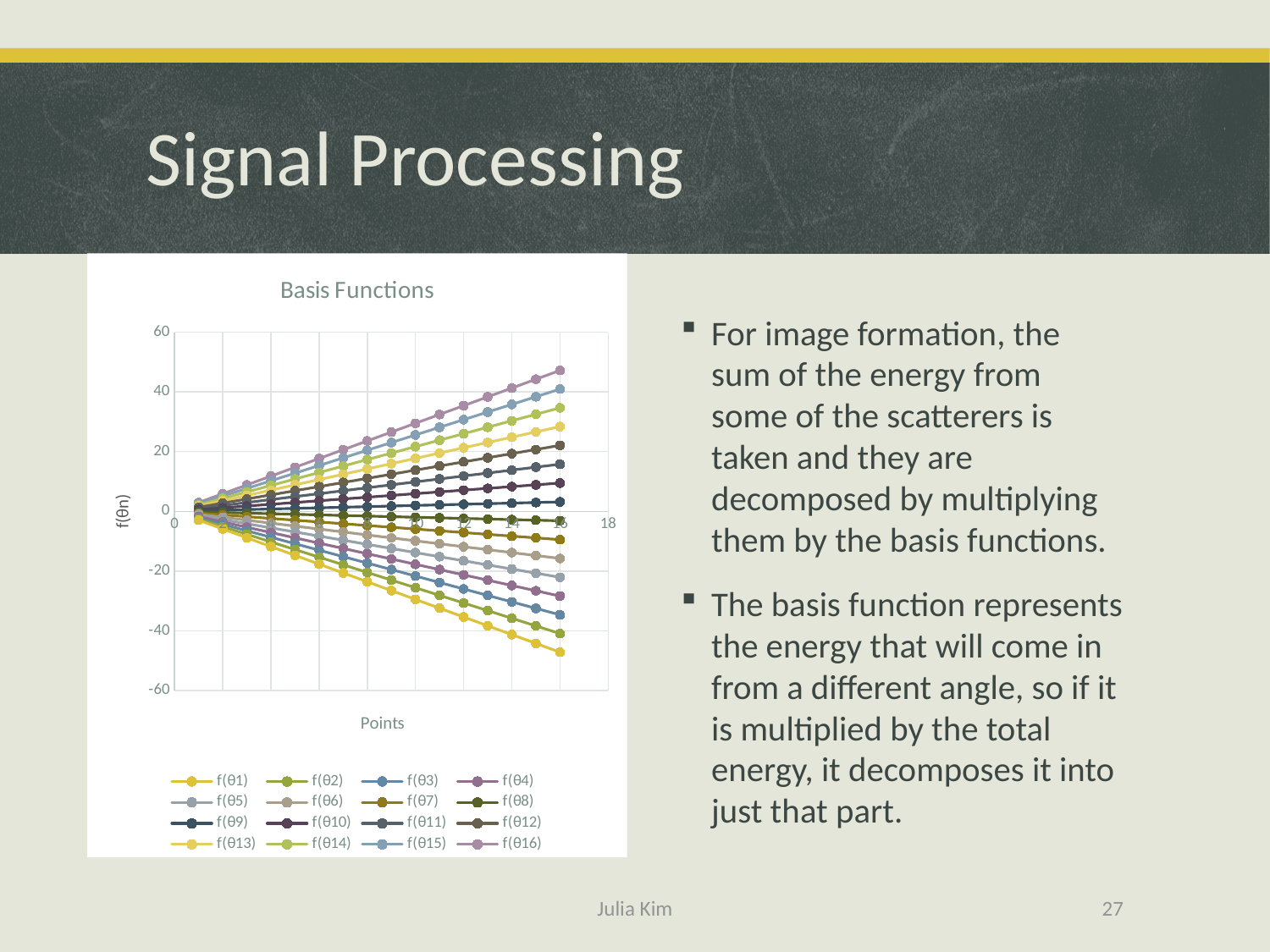
What is the lowest tick value shown on the y axis of the chart? -60 What is the label of the x axis of the chart? Points Is the highest value plotted at x = 16 greater or less than 40? greater Do the values of the topmost line rise or fall as x increases? rise What is the highest tick value shown on the x axis of the chart? 18 Do the values of the bottommost line rise or fall as x increases? fall Is the highest value plotted at x = 8 greater or less than 40? less What kind of chart is shown on the slide? line chart Is the lowest value plotted at x = 16 greater or less than -40? less How many series does the chart's legend list? 16 What is the title of the chart? Basis Functions What is the highest tick value shown on the y axis of the chart? 60